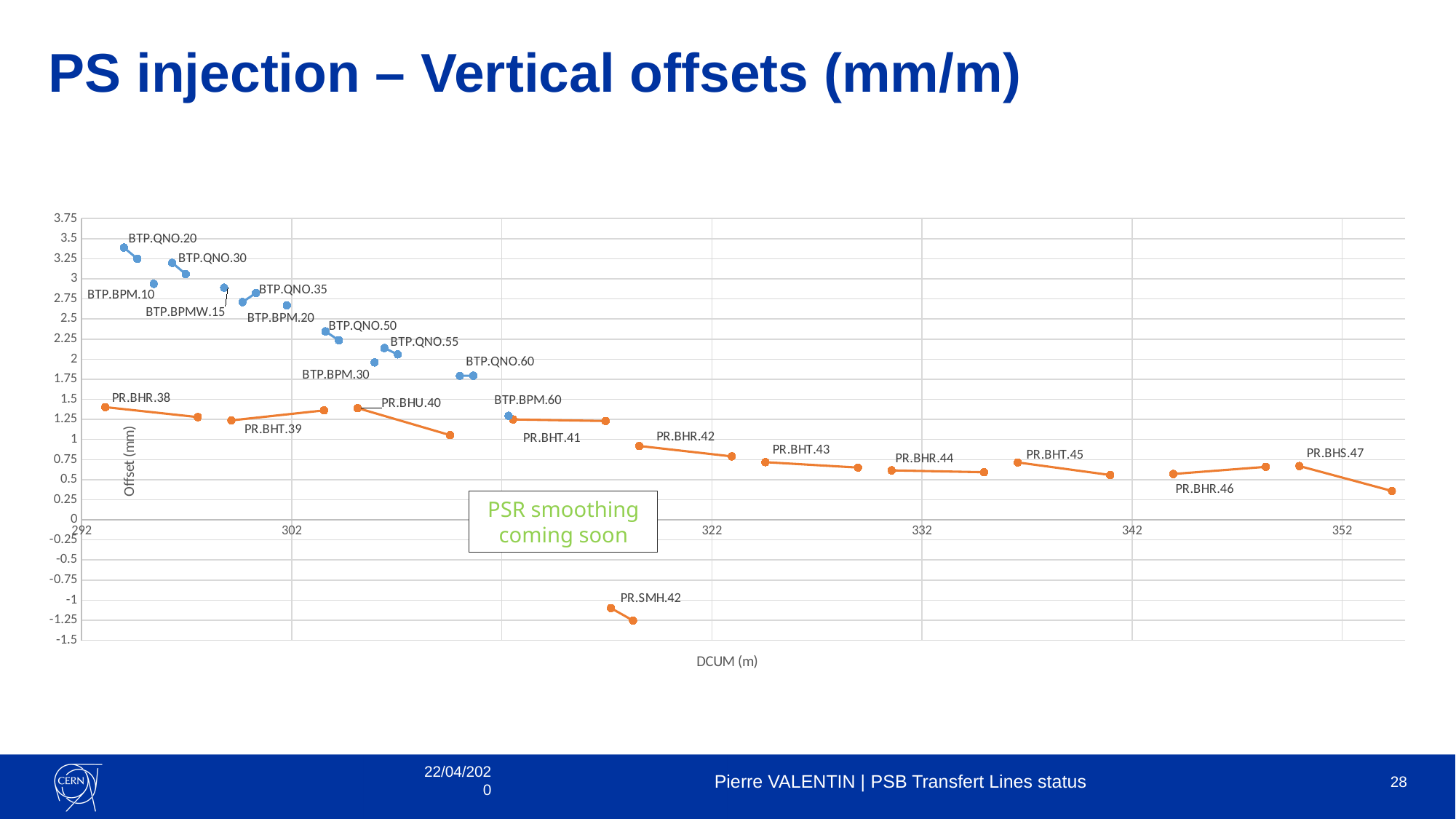
Which has a larger offset, BTP.QNO.20 or PR.BHR.38? BTP.QNO.20 What kind of chart is shown on the slide? Scatter chart with connected points (line chart) Which labeled element has the highest vertical offset on the chart? BTP.QNO.20 Overall, do the offsets rise or fall as DCUM increases along the x axis? fall Which has a larger offset, PR.BHS.47 or PR.SMH.42? PR.BHS.47 Which labeled element has the lowest vertical offset on the chart? PR.SMH.42 What is the label of the x axis? DCUM (m) Is the offset for BTP.QNO.60 greater or less than 2? less What text appears in the annotation box in the middle of the chart? PSR smoothing coming soon Is the offset for PR.BHR.42 greater or less than 1? less Are the offsets for PR.SMH.42 greater or less than 0? less